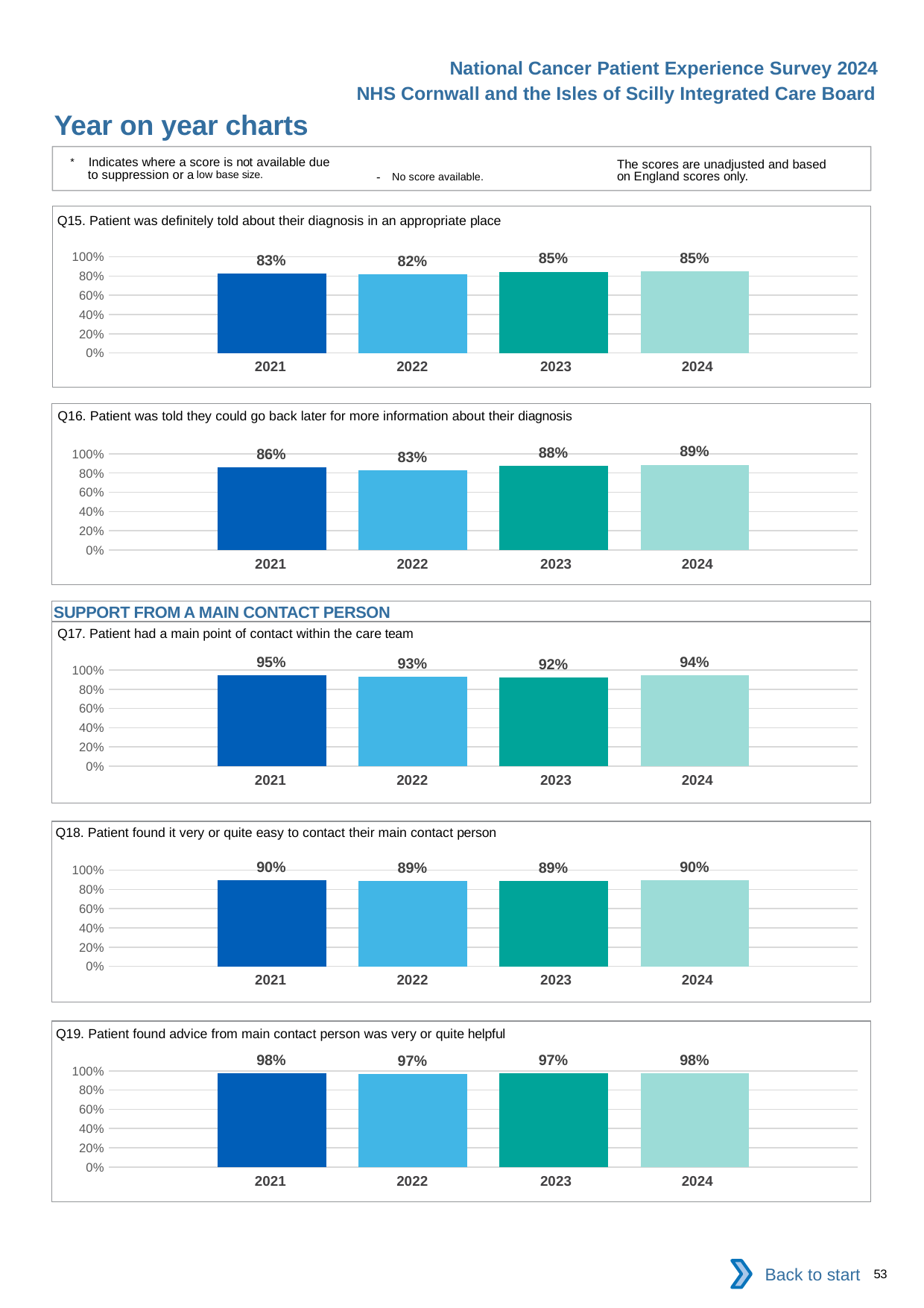
In the Q15 chart (Patient was definitely told about their diagnosis in an appropriate place), what is the value for 2022? 82% How many charts are shown on the slide? 5 In the Q17 chart (Patient had a main point of contact within the care team), what is the difference between the 2021 and 2023 values? 3 percentage points In the Q16 chart (Patient was told they could go back later for more information about their diagnosis), what is the difference between the 2024 and 2022 values? 6 percentage points In the Q16 chart (Patient was told they could go back later for more information about their diagnosis), which year has the highest value? 2024 In the Q19 chart (Patient found advice from main contact person was very or quite helpful), what is the value for 2024? 98% In the Q18 chart (Patient found it very or quite easy to contact their main contact person), what is the value for 2023? 89% In the Q17 chart (Patient had a main point of contact within the care team), which year has the highest value? 2021 What kind of chart is the Q19 chart (Patient found advice from main contact person was very or quite helpful)? Bar chart In the Q15 chart (Patient was definitely told about their diagnosis in an appropriate place), is the value for 2023 larger than the value for 2022? Yes In the Q16 chart (Patient was told they could go back later for more information about their diagnosis), which year has the lowest value? 2022 How many years are shown on the x axis of the Q18 chart (Patient found it very or quite easy to contact their main contact person)? 4